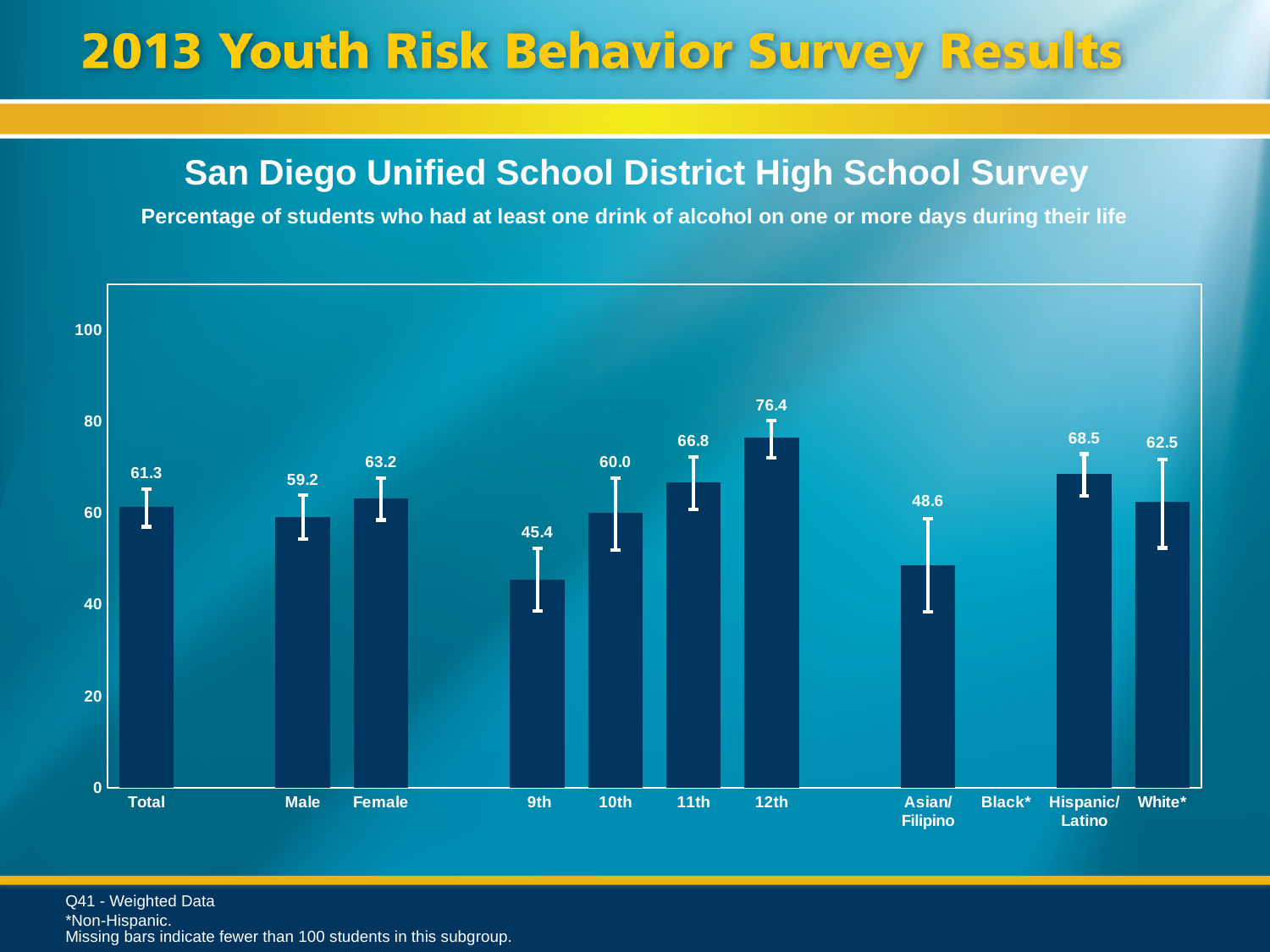
How many categories have a plotted bar? 10 Is the value for 11th grade greater or less than 60? greater What is the difference between the 12th and 9th grade values? 31.0 Which category with a plotted bar has the lowest value? 9th What is the difference between the Female and Male values? 4.0 Do the values rise or fall from 9th grade to 12th grade? rise Which category has the highest value? 12th Which is larger, the value for Hispanic/Latino or the value for White*? Hispanic/Latino What is the value for the Total category? 61.3 What is the value for Asian/Filipino students? 48.6 What kind of chart is shown? bar chart What is the value for 12th grade students? 76.4